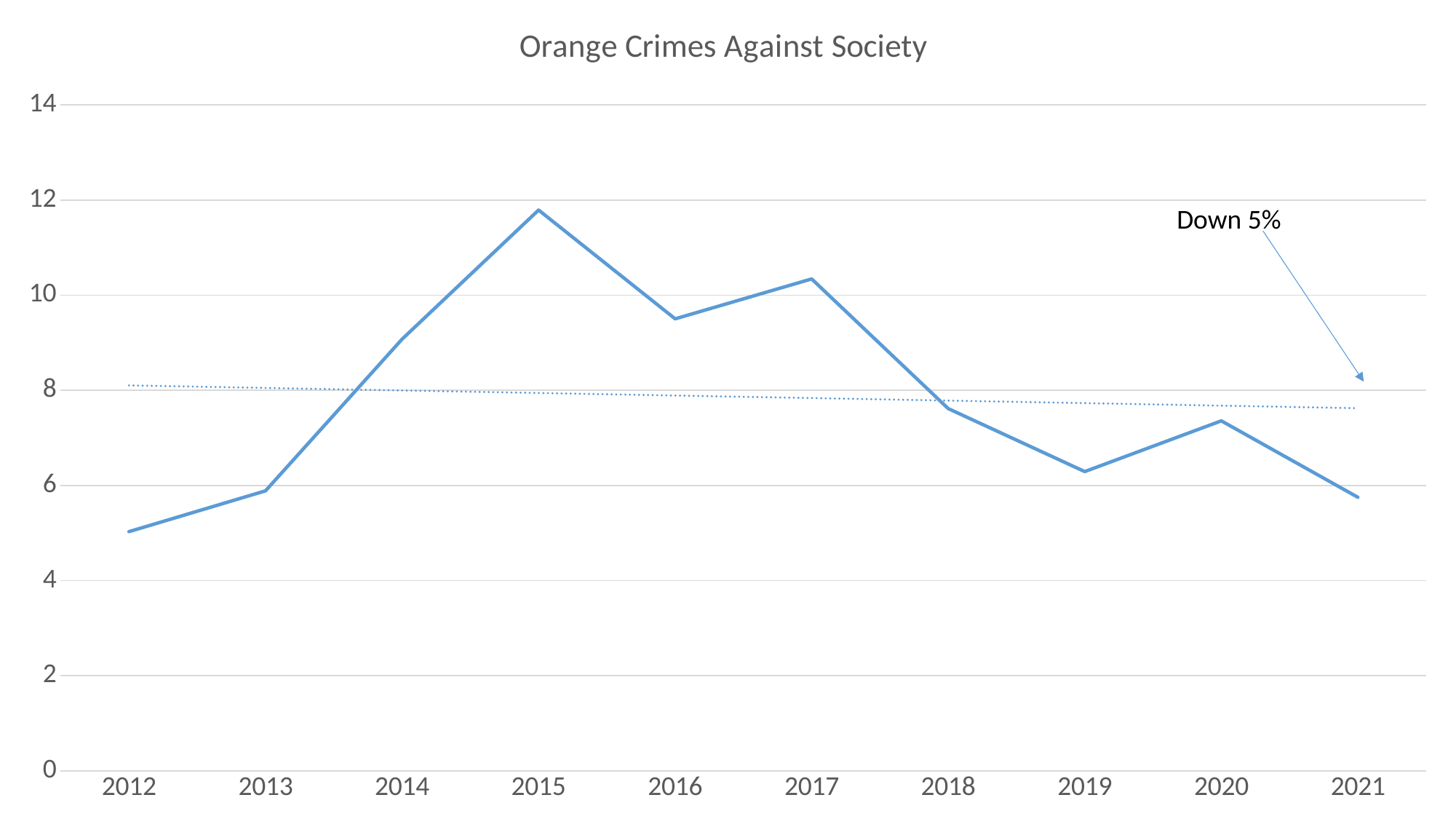
What is the title of the chart? Orange Crimes Against Society Is the value for 2012 greater or less than 6? less Which year has the lowest value on the chart? 2012 Is the value for 2015 greater or less than 10? greater Is the value for 2017 greater or less than 10? greater What does the text annotation with the arrow on the chart say? Down 5% Which is larger, the value for 2016 or the value for 2018? 2016 Which year has the highest value on the chart? 2015 How many years are plotted along the x axis? 10 What kind of chart is shown on the slide? line chart Do the values rise or fall from 2012 to 2015? rise